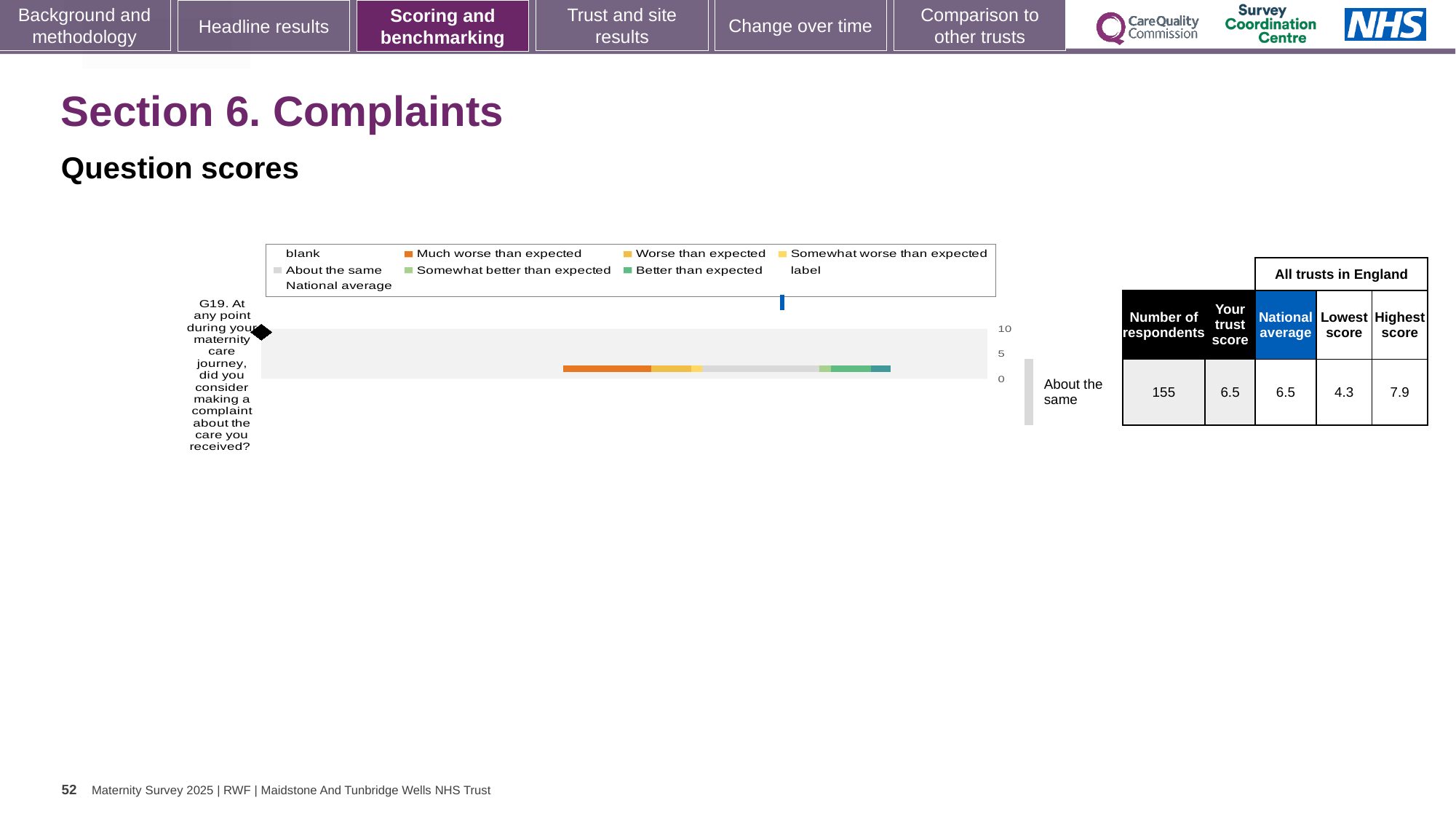
In the table beside the chart, what is the lowest score among all trusts in England for question G19? 4.3 Which question code is plotted on the chart? G19 How many survey questions are plotted on the chart? 1 Is the trust score for question G19 larger than, smaller than, or equal to the national average? equal What kind of chart is shown on the slide? bar chart What is the difference between the highest score and the lowest score for question G19? 3.6 What colour does the legend use for 'Much worse than expected'? orange In the table beside the chart, what is the number of respondents for question G19? 155 In the table beside the chart, what is the highest score among all trusts in England for question G19? 7.9 In the table beside the chart, what is the national average for question G19? 6.5 In the table beside the chart, what is the trust score for question G19? 6.5 Which benchmark category is shown next to the chart for question G19? About the same